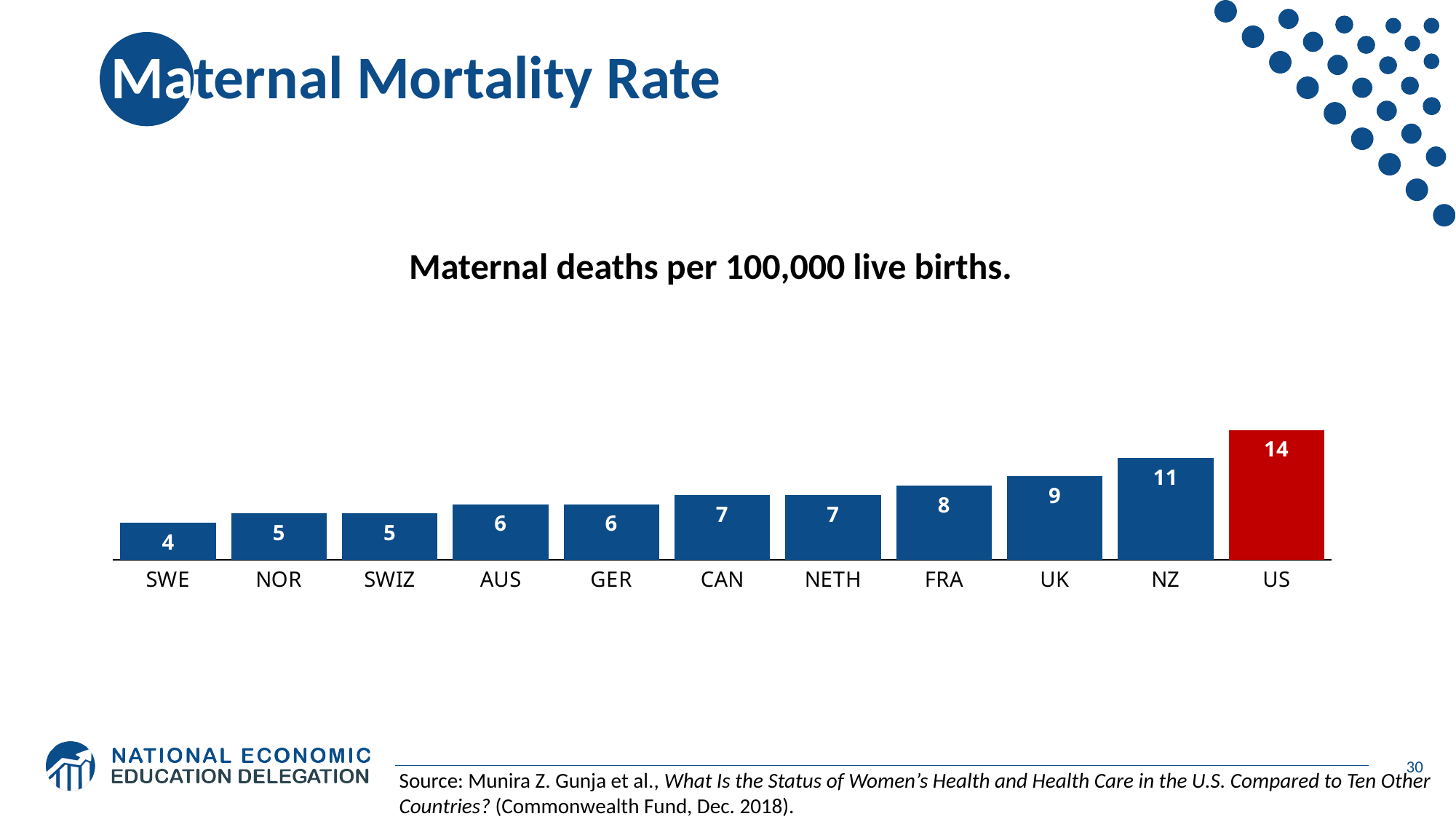
What is the difference between the values for the US and the UK? 5 What value is shown for SWE? 4 Which country has the highest maternal mortality rate on the chart? US Which country has the lowest maternal mortality rate on the chart? SWE What is the difference between the values for NZ and SWE? 7 What value is shown for FRA? 8 What kind of chart is shown on the slide? Bar chart Which bar is coloured red rather than blue? US What is the value for NZ? 11 What is the maternal mortality rate shown for the US? 14 Which has a higher value, CAN or NOR? CAN How many countries are shown on the chart? 11